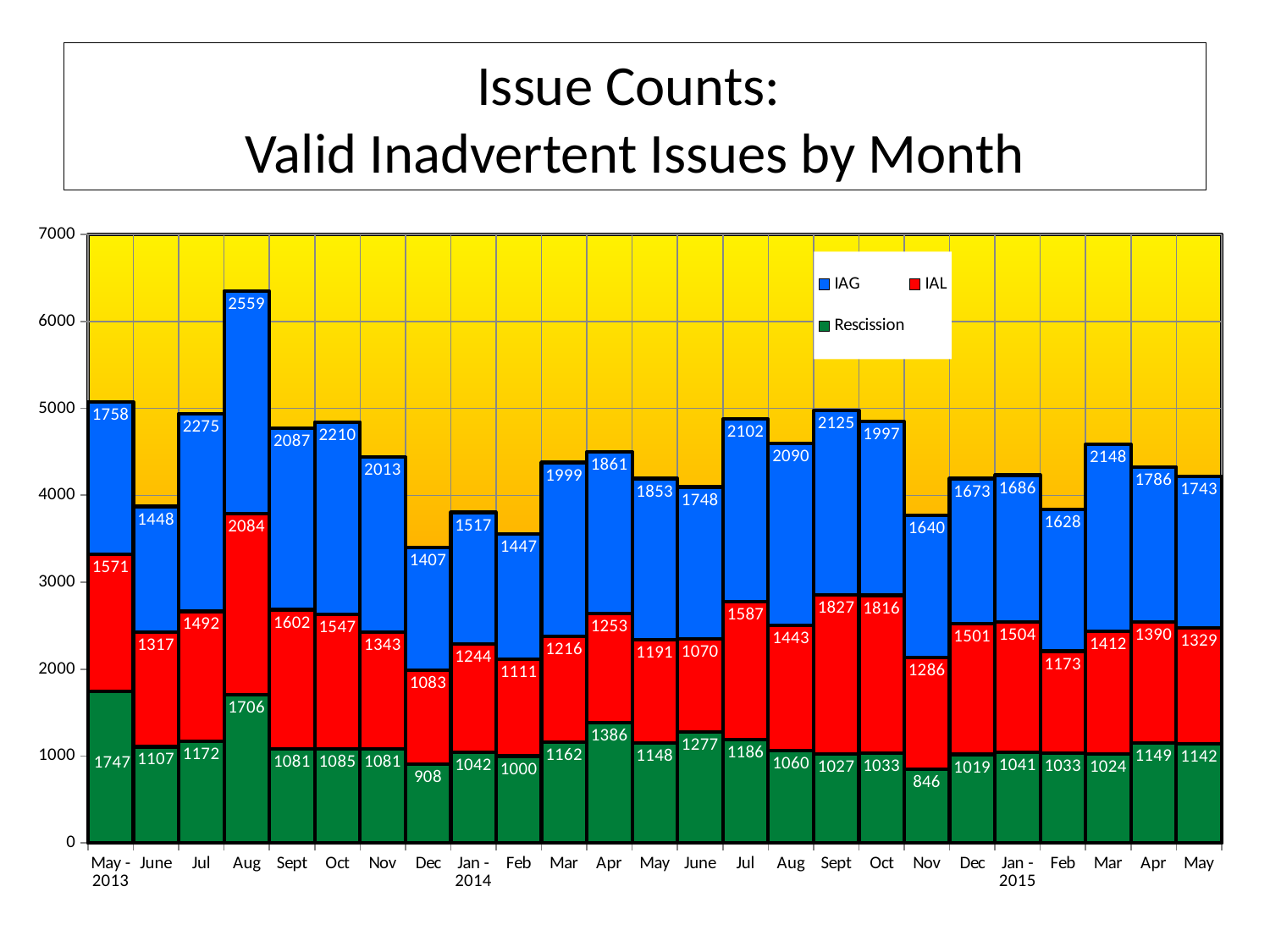
What is the Rescission value for Dec 2013? 908 Which month has the lowest Rescission value? Nov 2014 Which month has the highest IAG value? Aug 2013 What kind of chart is shown on the slide? Stacked bar chart Which is larger, the IAG value for Mar 2015 or the IAG value for Jul 2014? Mar 2015 What is the IAG value for Aug 2013? 2559 How many series does the legend list? 3 What is the total of the stacked bar for Dec 2013? 3398 What is the total of the stacked bar for Aug 2013? 6349 What is the IAL value for Sept 2014? 1827 How many months are shown on the x axis? 25 What is the difference between the IAL values for Aug 2013 and Jul 2013? 592